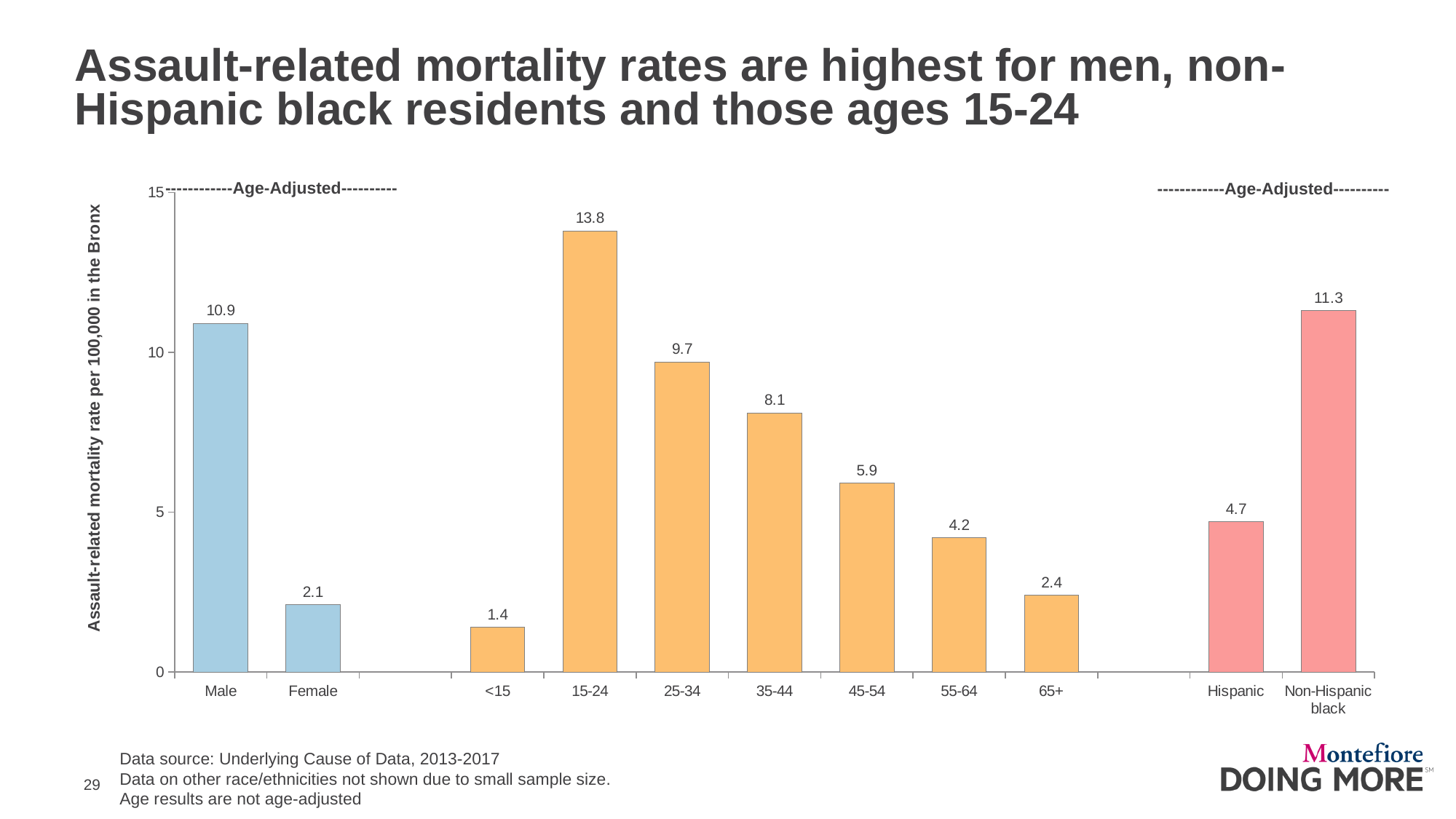
What is the assault-related mortality rate for the 15-24 age group? 13.8 Which has a higher assault-related mortality rate, the 25-34 age group or the 35-44 age group? 25-34 What is the assault-related mortality rate for Male residents? 10.9 What is the assault-related mortality rate for Non-Hispanic black residents? 11.3 What is the difference between the Male and Female assault-related mortality rates? 8.8 Which category has the highest assault-related mortality rate on the chart? 15-24 What kind of chart is shown on the slide? Bar chart Which age group has the lowest assault-related mortality rate? <15 What is the difference between the Non-Hispanic black and Hispanic mortality rates? 6.6 Do the values rise or fall across the age groups from 15-24 to 65+? Fall How many age groups are shown on the chart? 7 Is the value for the 45-54 age group greater or less than 5? greater